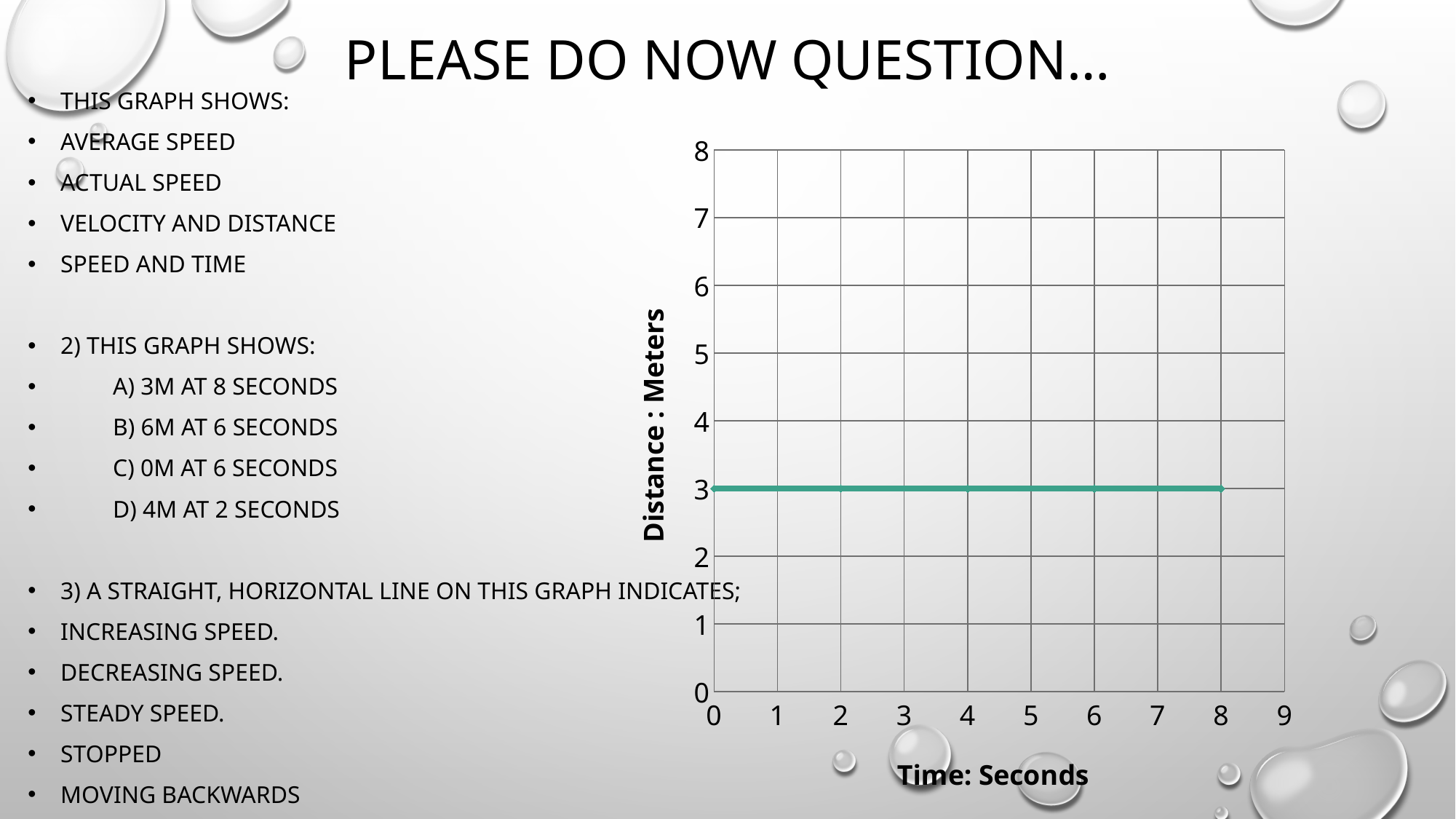
What is the label of the vertical axis of the graph? Distance : Meters What is the highest value shown on the vertical axis of the graph? 8 What is the distance in meters at 8 seconds on the graph? 3 What is the distance in meters at 2 seconds on the graph? 3 Does the plotted distance rise, fall, or stay constant as time increases? stays constant Is the distance at 4 seconds greater or less than 5 meters? less What is the label of the horizontal axis of the graph? Time: Seconds Is the distance at 6 seconds greater or less than 2 meters? greater Is the distance at 8 seconds larger than, smaller than, or equal to the distance at 0 seconds? equal What kind of chart is shown on the slide? line chart At what time in seconds does the plotted line end? 8 What is the distance in meters at 6 seconds on the graph? 3